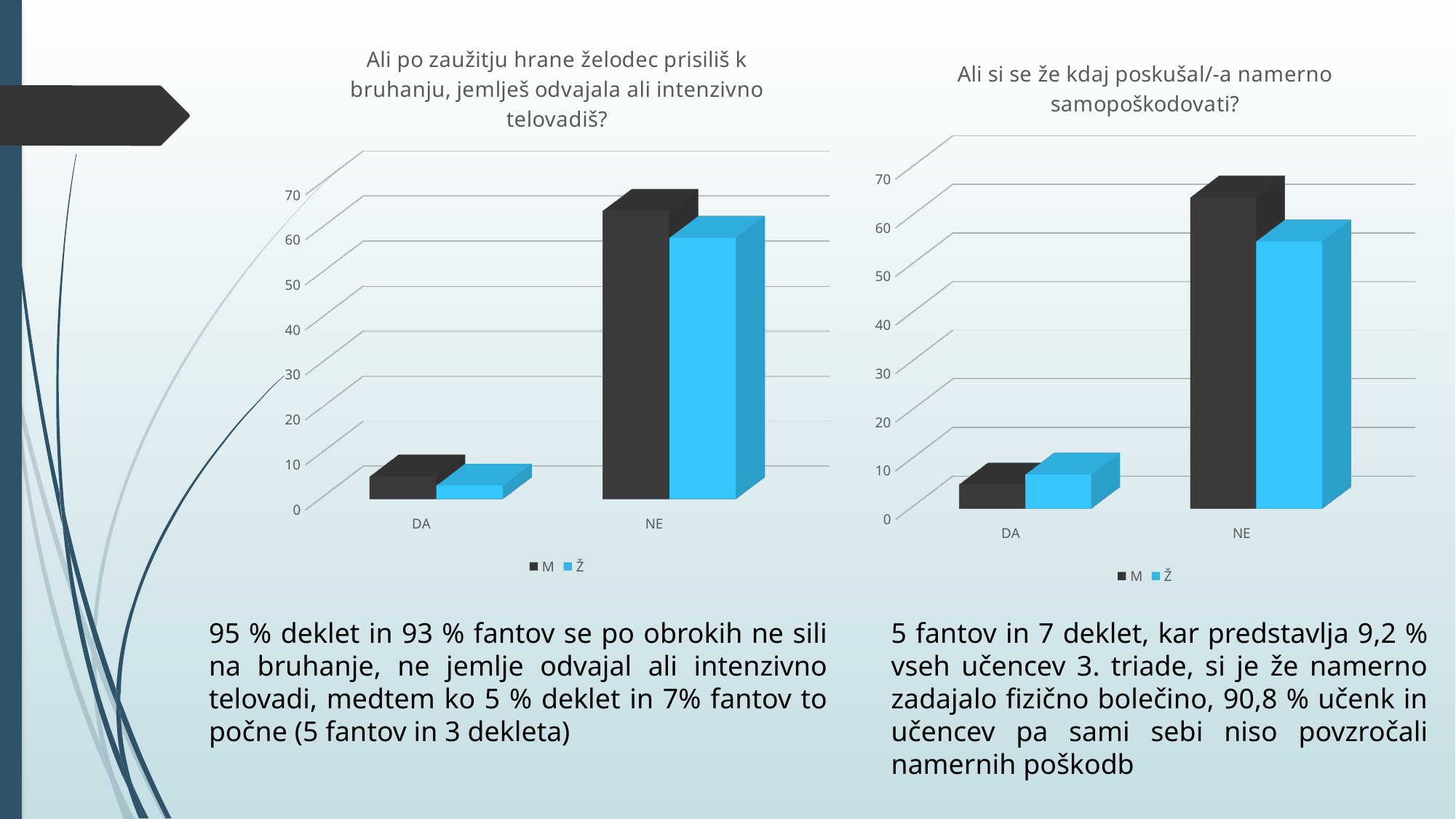
In the left chart, is the value for M in category NE greater or less than 60? greater What type of chart is the left chart titled "Ali po zaužitju hrane želodec prisiliš k bruhanju, jemlješ odvajala ali intenzivno telovadiš?"? Bar chart How many series does the legend of the right chart ("Ali si se že kdaj poskušal/-a namerno samopoškodovati?") list? 2 In the left chart, is the value for Ž in category DA greater or less than 10? less How many categories are shown on the x axis of the right chart? 2 In the right chart, is the value for M in category NE greater or less than 60? greater In the left chart, for category NE, which series has the larger value, M or Ž? M In the left chart, which category has the highest bar for series M? NE In the right chart, which category has the lowest bar for series Ž? DA In the right chart, for category DA, which series has the larger value, M or Ž? Ž What are the series names in the legend of the left chart? M and Ž